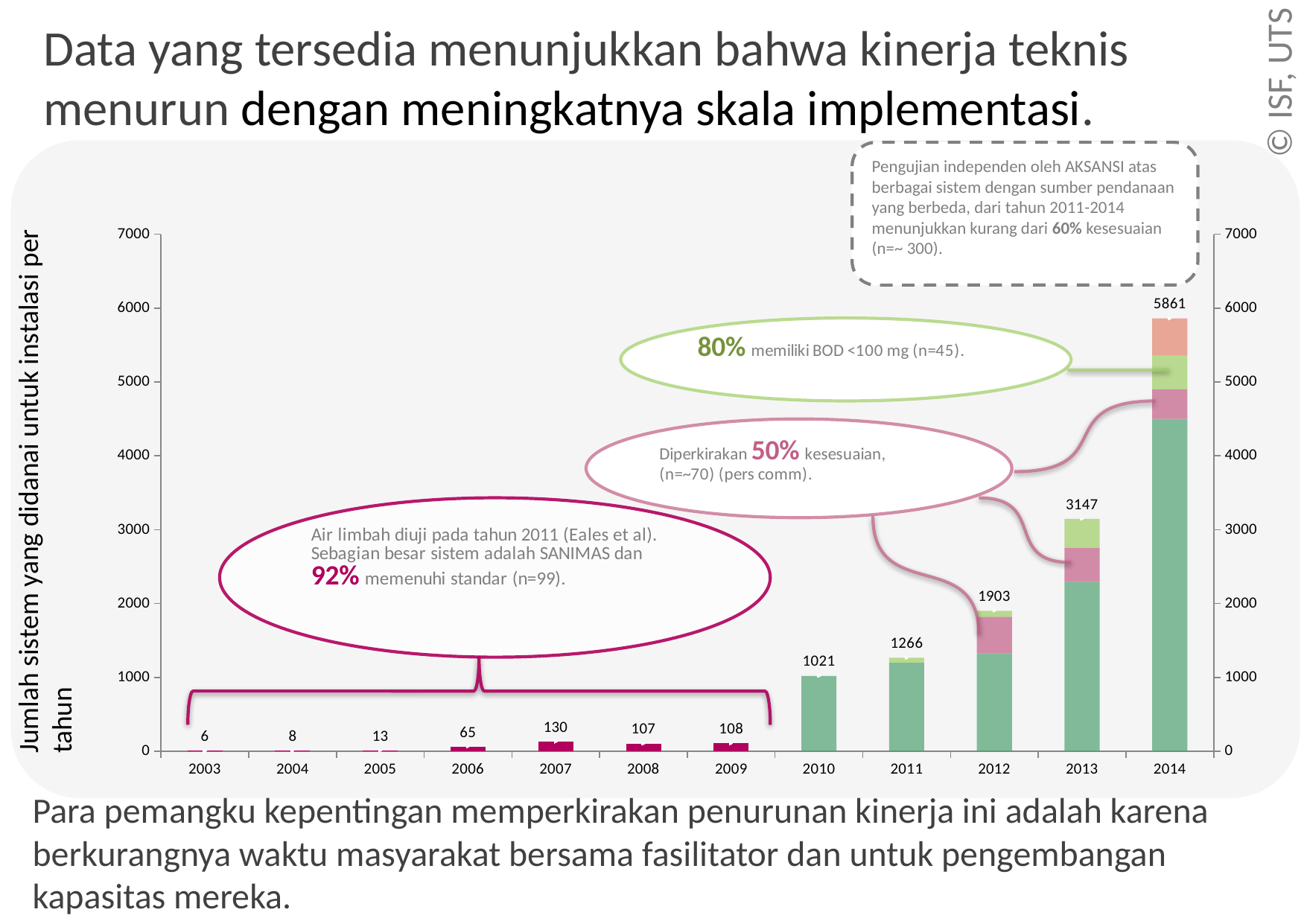
How many years are shown on the x axis? 12 What is the difference between the values for 2011 and 2010? 245 What is the difference between the totals for 2014 and 2013? 2714 What is the value shown for 2010? 1021 What kind of chart is shown on the slide? Stacked bar chart Which is larger, the value for 2008 or the value for 2009? 2009 What is the value shown for 2003? 6 Which year has the highest total? 2014 What is the total value shown for 2014? 5861 What is the value shown for 2007? 130 Is the total for 2013 greater or less than 3000? greater Which year has the lowest value? 2003